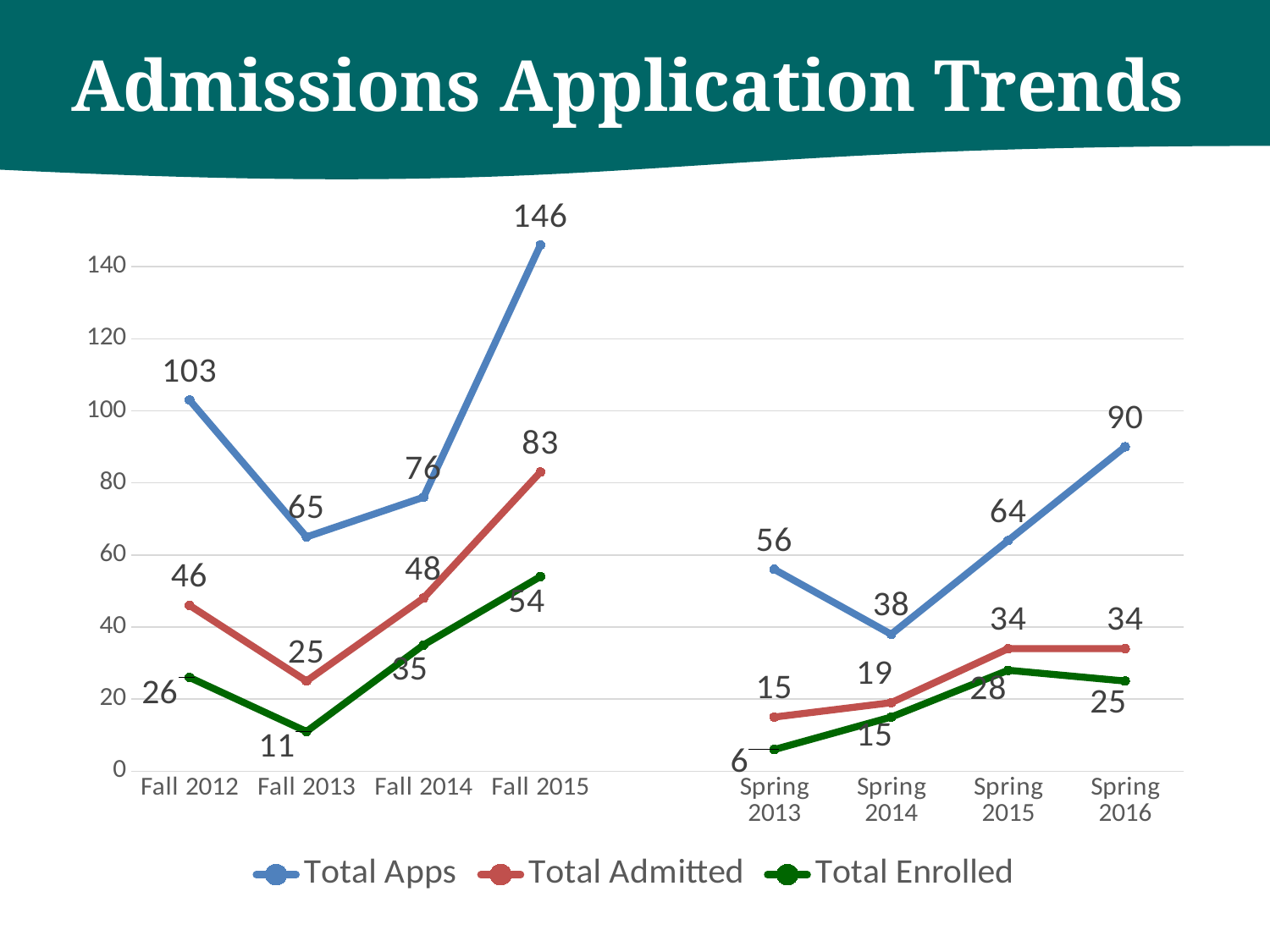
Which period has the highest value for Total Apps? Fall 2015 What is the value of Total Enrolled for Fall 2013? 11 Is the value of Total Apps for Spring 2015 greater or less than 60? greater What kind of chart is shown on the slide? Line chart Which period has the lowest value for Total Enrolled? Spring 2013 How many periods are shown on the x axis? 8 What is the difference between Total Apps and Total Admitted in Fall 2015? 63 What is the value of Total Apps for Fall 2015? 146 How many series does the legend list? 3 What is the value of Total Admitted for Spring 2014? 19 What is the title of the slide? Admissions Application Trends Which is larger: Total Apps in Fall 2012 or Total Apps in Spring 2016? Fall 2012